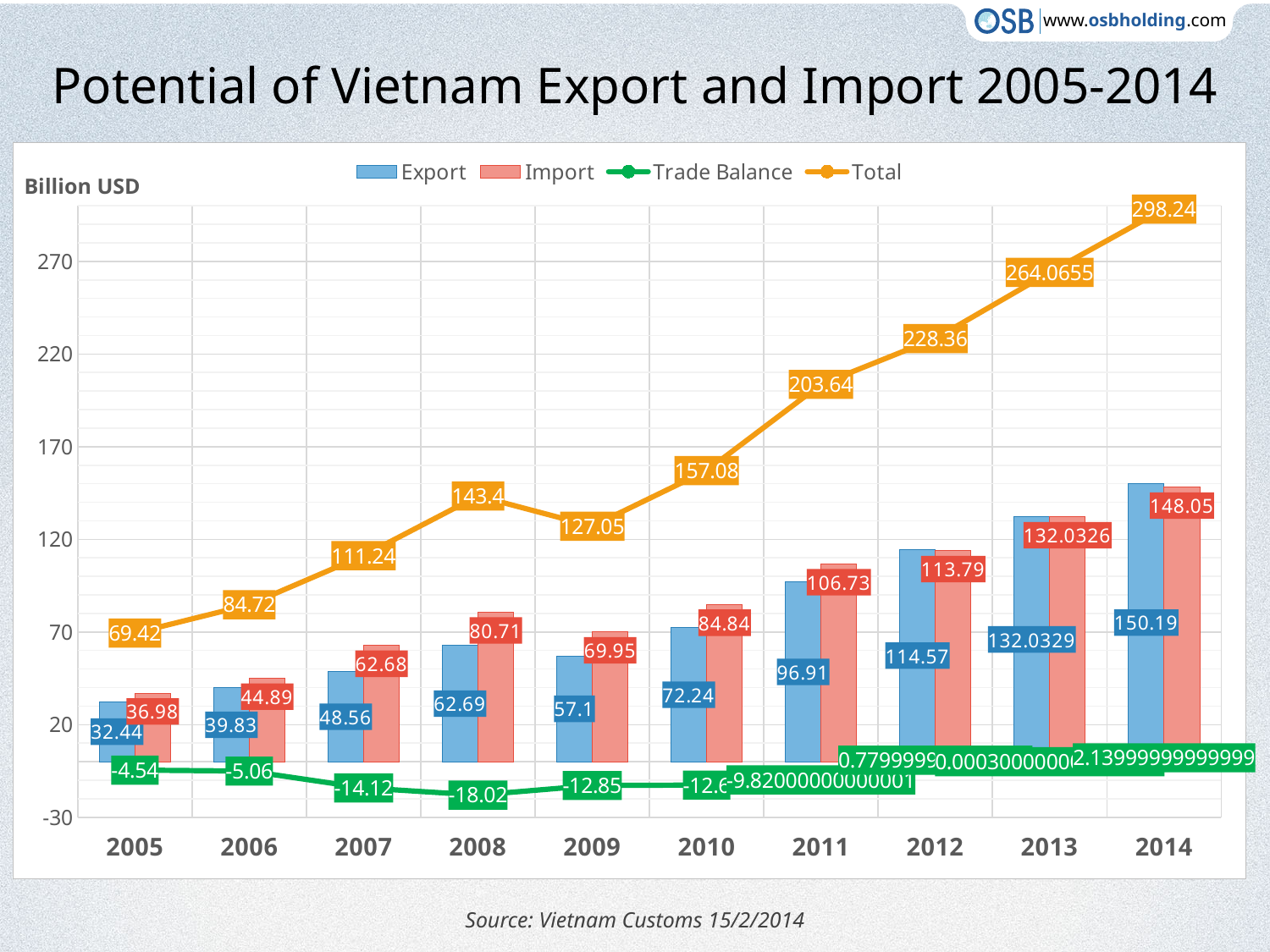
How many years are shown on the x axis? 10 Does the Total series rise or fall from 2010 to 2014? Rises What is the Export value for 2011? 96.91 In 2012, which is larger, Export or Import? Export What is the Trade Balance value for 2008? -18.02 What is the Total value for 2014? 298.24 How many series does the legend list? 4 What is the Import value for 2008? 80.71 What is the difference between the Import and Export values in 2007? 14.12 In which year is the Total value highest? 2014 What kind of chart is this? Combination bar and line chart In which year is the Export value lowest? 2005